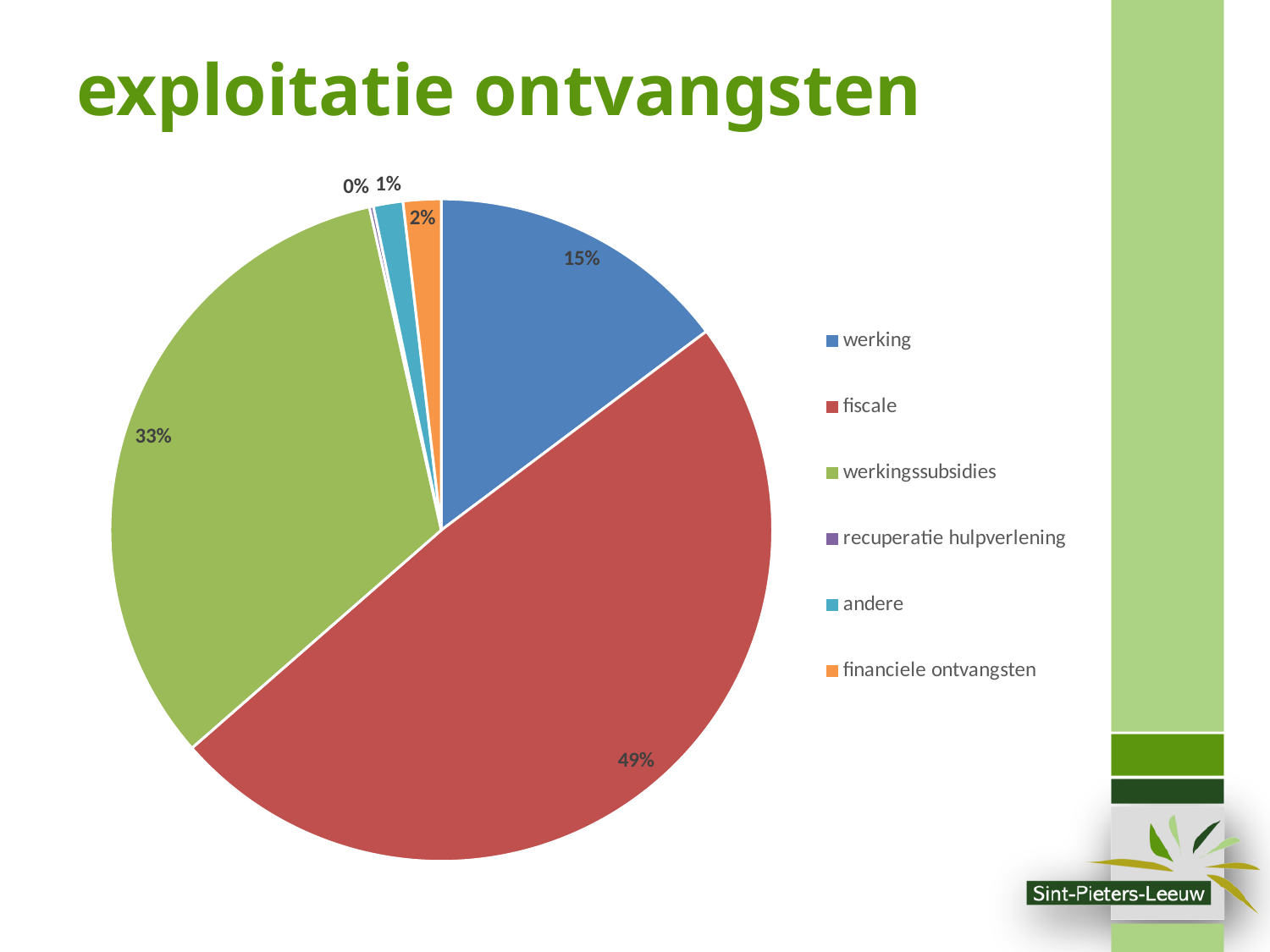
Which is larger, the slice for werking or the slice for werkingssubsidies? werkingssubsidies How many categories does the legend list? 6 What is the title of the chart? exploitatie ontvangsten What share of the pie does financiele ontvangsten have? 2% Which category has the smallest slice of the pie? recuperatie hulpverlening Which category has the largest slice of the pie? fiscale What share of the pie does fiscale have? 49% What is the difference in percentage points between fiscale and werkingssubsidies? 16 What share of the pie does werkingssubsidies have? 33% What kind of chart is shown on the slide? pie chart